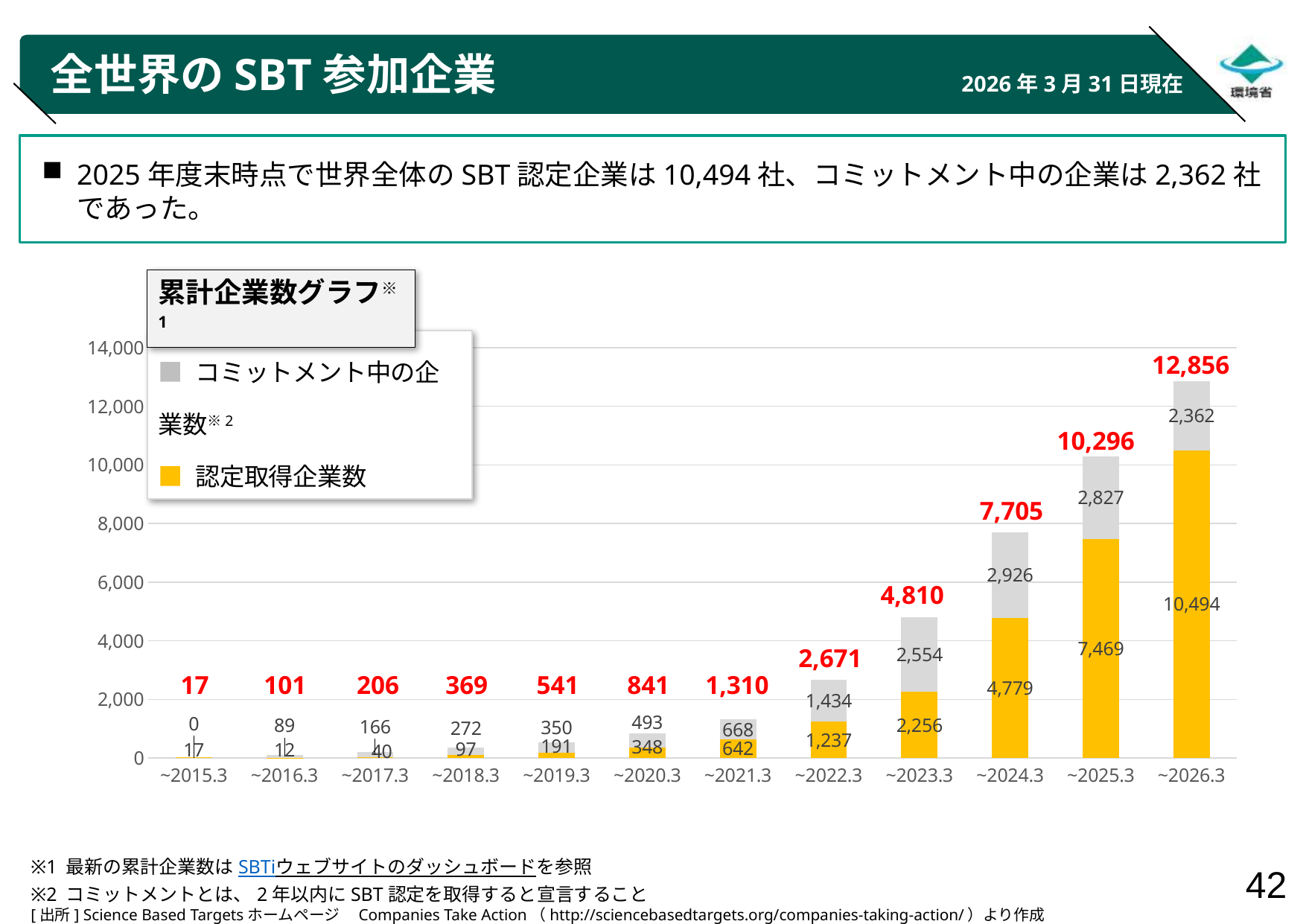
Which category has the lowest total? ~2015.3 Which colour represents 認定取得企業数 in the chart? yellow What is the value of 認定取得企業数 for ~2026.3? 10,494 Do the total values rise or fall from ~2015.3 to ~2026.3? rise What is the total of the stacked bar for ~2025.3? 10,296 How many series does the legend list? 2 What is the difference between 認定取得企業数 for ~2026.3 and ~2025.3? 3,025 What is the value of コミットメント中の企業数 for ~2024.3? 2,926 How many categories are shown on the x axis? 12 Which category has the highest total? ~2026.3 Which is larger for ~2023.3: コミットメント中の企業数 or 認定取得企業数? コミットメント中の企業数 What type of chart is shown on the slide? stacked bar chart